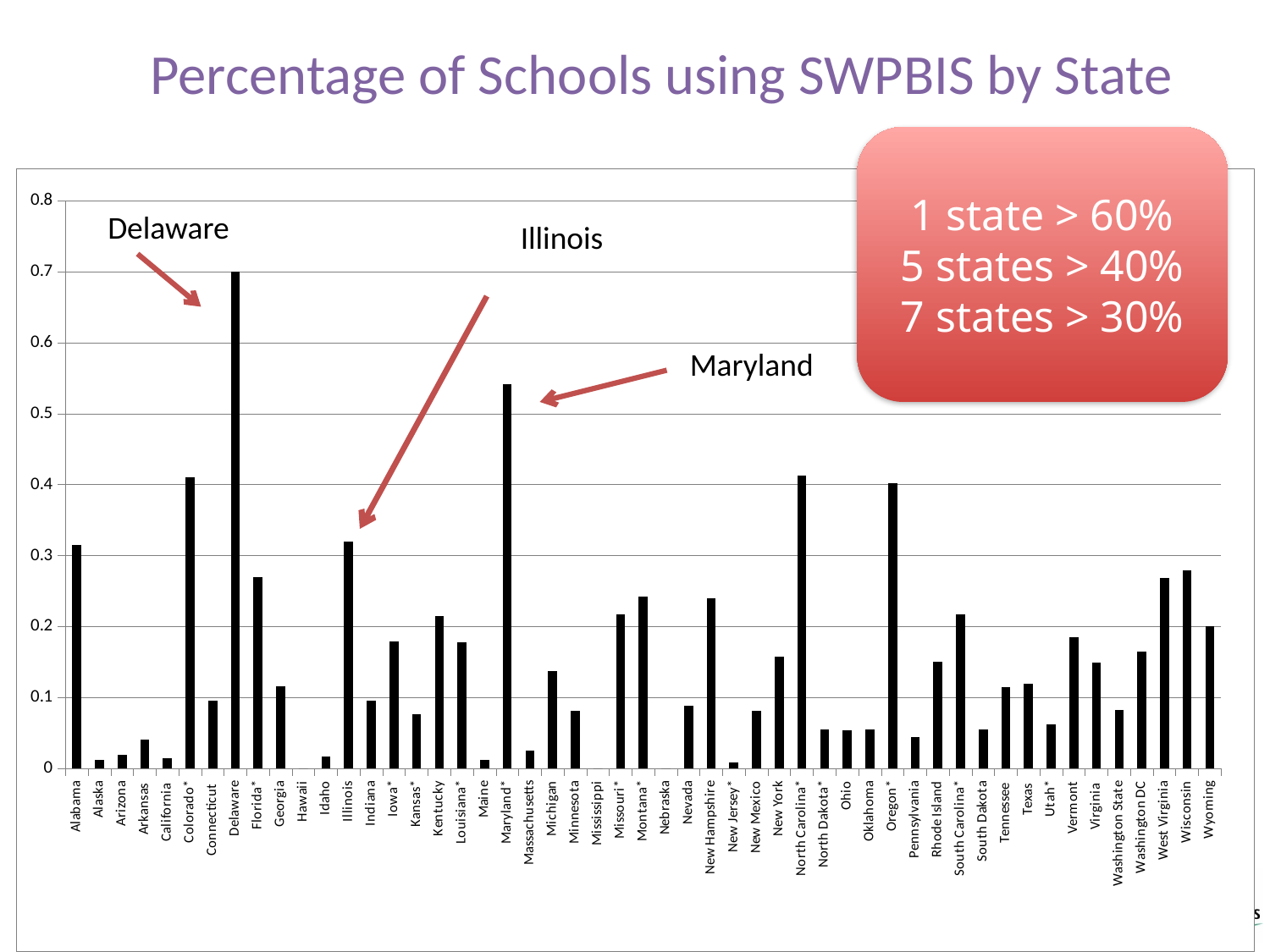
Is the value for Maryland* greater or less than 0.5? greater Which state has the highest percentage of schools using SWPBIS? Delaware What is the value for Delaware? 0.7 What kind of chart is shown on the slide? bar chart What is the title of the chart? Percentage of Schools using SWPBIS by State According to the callout box on the slide, how many states are above 40%? 5 states Is the value for Florida* greater or less than 0.3? less Which is larger, the value for Delaware or the value for Maryland*? Delaware Is the value for Illinois greater or less than 0.3? greater Which is larger, the value for Colorado* or the value for Illinois? Colorado*